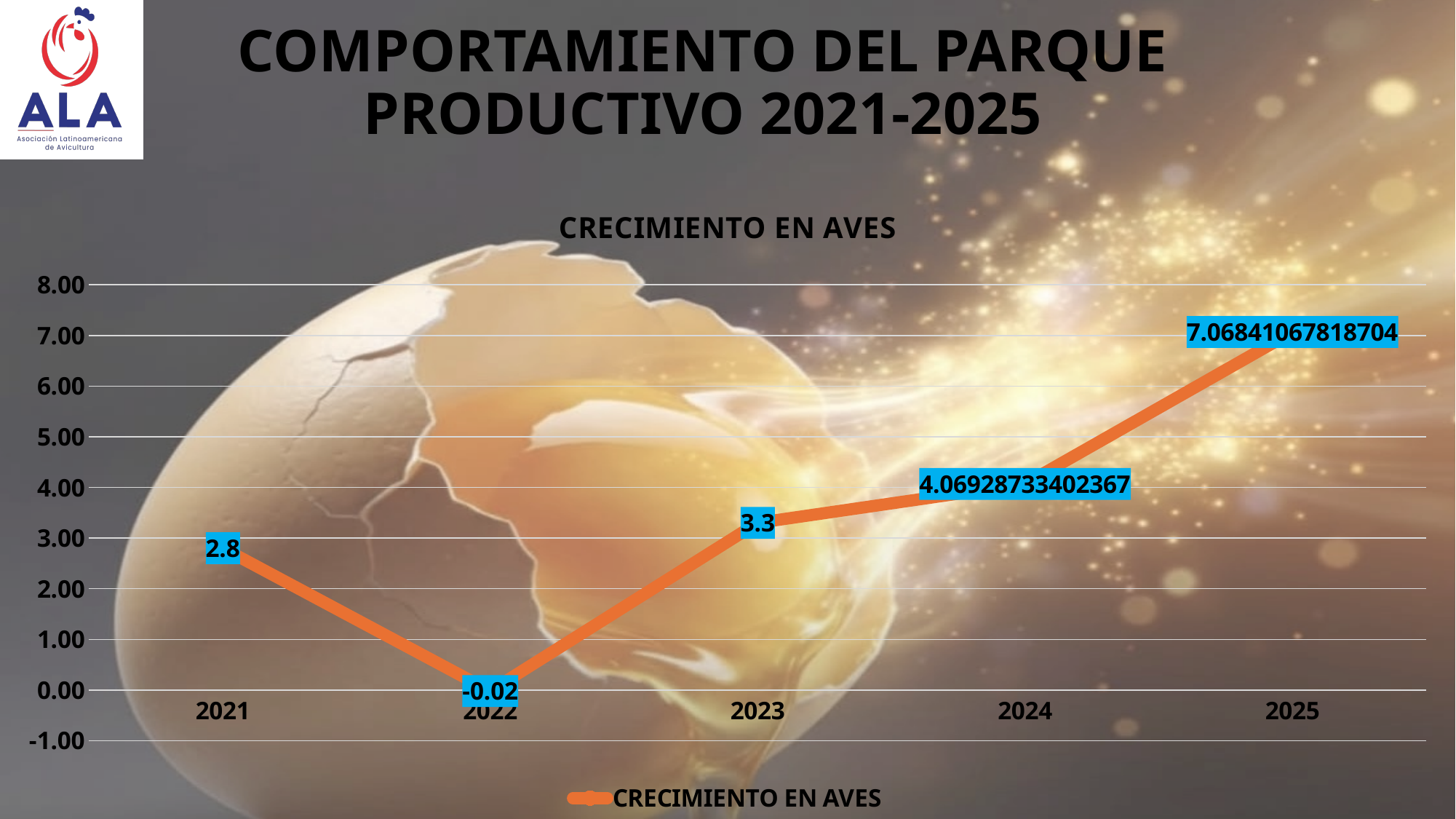
Which year has the lowest value in the CRECIMIENTO EN AVES chart? 2022 Which is larger in the CRECIMIENTO EN AVES chart, the value for 2021 or the value for 2023? 2023 What is the value for 2025 in the CRECIMIENTO EN AVES chart? 7.06841067818704 Does the value in the CRECIMIENTO EN AVES chart rise or fall from 2022 to 2025? rise Is the value for 2024 in the CRECIMIENTO EN AVES chart greater or less than 4.00? greater What is the difference between the values for 2023 and 2021 in the CRECIMIENTO EN AVES chart? 0.5 How many years are plotted in the CRECIMIENTO EN AVES chart? 5 What kind of chart is the CRECIMIENTO EN AVES chart? line chart What is the value for 2023 in the CRECIMIENTO EN AVES chart? 3.3 What is the value for 2021 in the CRECIMIENTO EN AVES chart? 2.8 What is the value for 2022 in the CRECIMIENTO EN AVES chart? -0.02 Which year has the highest value in the CRECIMIENTO EN AVES chart? 2025